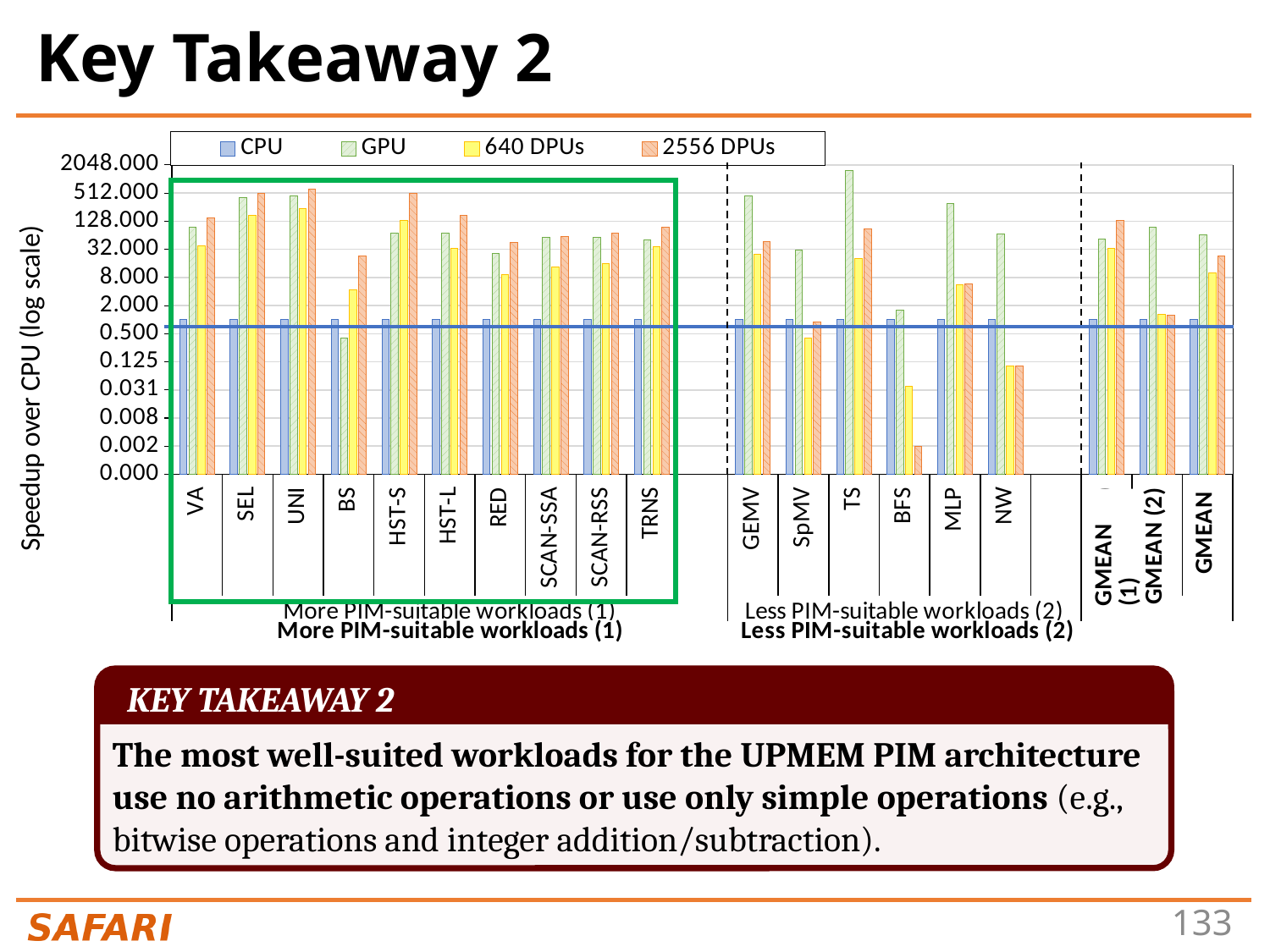
How many workload categories are plotted on the x axis, including the GMEAN categories? 19 For MLP, which is larger: the GPU value or the 640 DPUs value? GPU Is the 2556 DPUs value for BFS greater or less than 0.031? less Is the GPU value for TS greater or less than 512? greater Which category has the highest GPU bar? TS How many series does the chart legend list? 4 For BS, which is larger: the GPU value or the 2556 DPUs value? 2556 DPUs Is the 640 DPUs value for NW greater or less than 0.5? less What kind of chart is shown on the slide? bar chart What is the label of the y axis of the chart? Speedup over CPU (log scale) Which category has the lowest 2556 DPUs bar? BFS What are the four series listed in the chart legend? CPU, GPU, 640 DPUs, 2556 DPUs